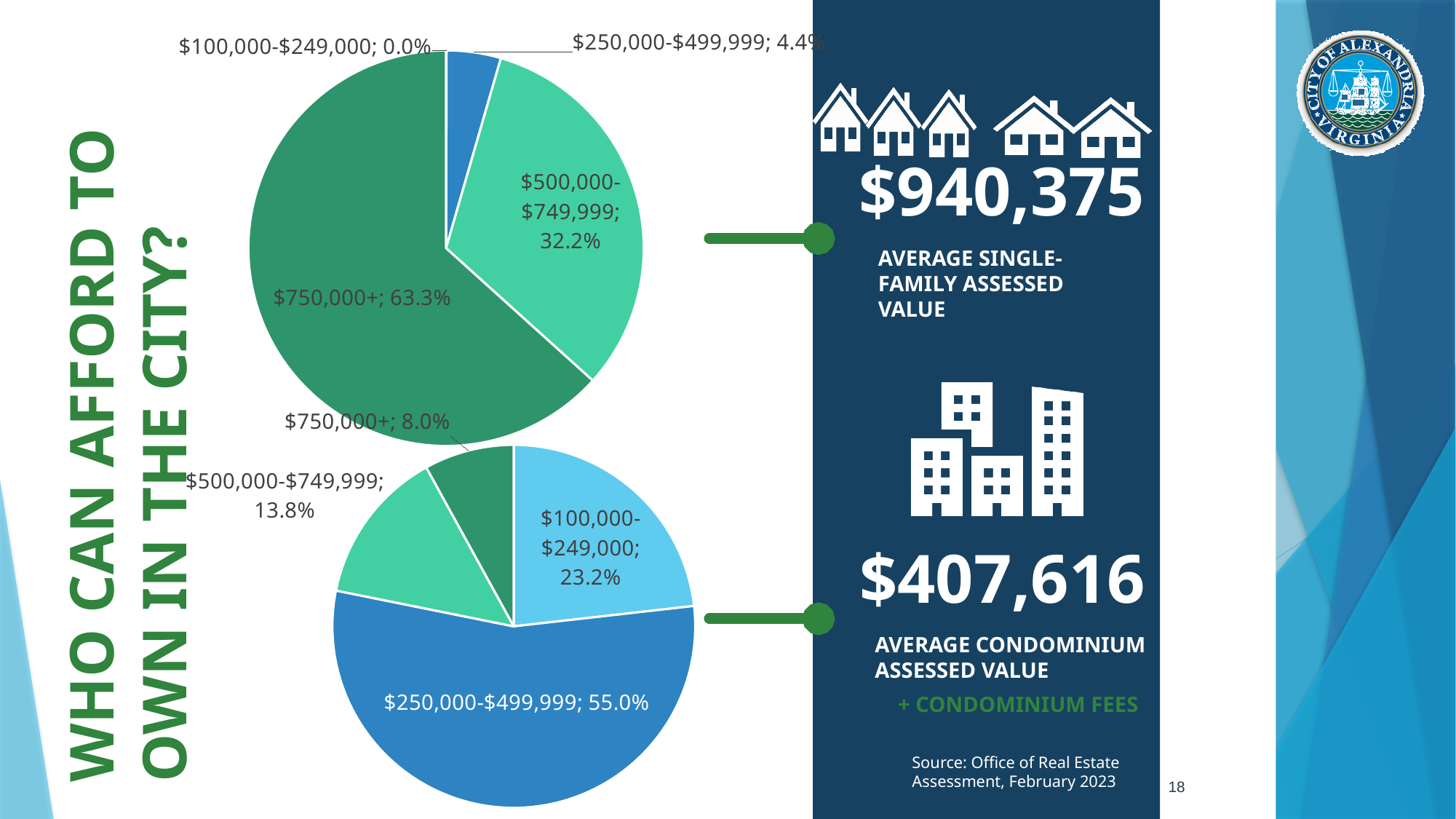
In the top pie chart, what share is labelled for the $750,000+ slice? 63.3% In the bottom pie chart, which category has the largest share? $250,000-$499,999 In the top pie chart, which category has the smallest share? $100,000-$249,000 In the bottom pie chart, what is the difference between the $500,000-$749,999 share and the $750,000+ share? 5.8% In the top pie chart, what share is labelled for the $500,000-$749,999 slice? 32.2% In the top pie chart, which is larger: the $750,000+ share or the $500,000-$749,999 share? $750,000+ In the bottom pie chart, which category has the smallest share? $750,000+ In the top pie chart, what share is labelled for the $250,000-$499,999 slice? 4.4% What type of chart is the top chart on the slide? Pie chart In the bottom pie chart, what share is labelled for the $250,000-$499,999 slice? 55.0% In the bottom pie chart, what share is labelled for the $100,000-$249,000 slice? 23.2% How many slices are labelled in the bottom pie chart? 4